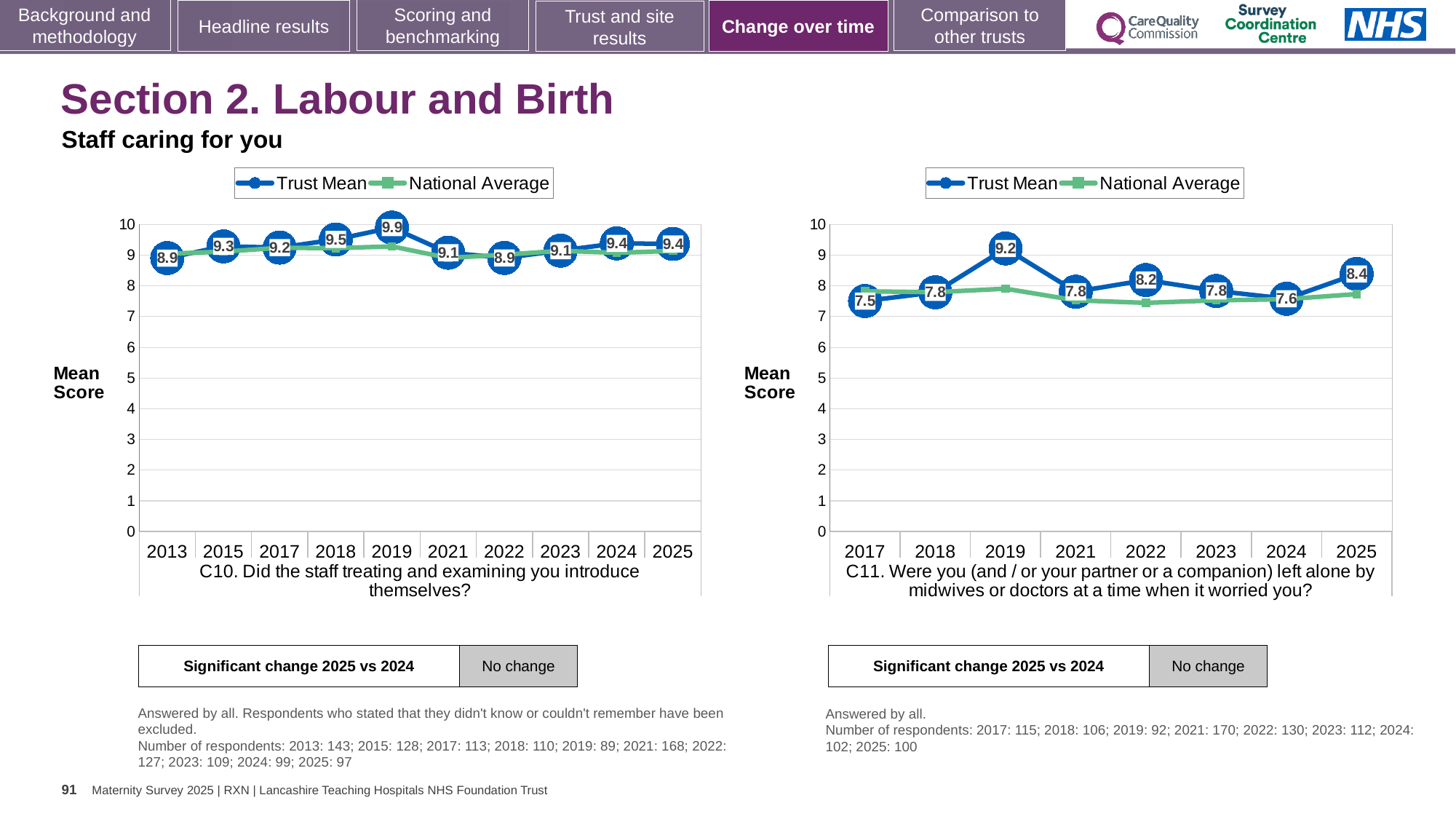
In the C11 chart on the right, which year has the highest Trust Mean? 2019 In the C11 chart on the right, which year has the lowest Trust Mean? 2017 In the C10 chart on the left, what is the Trust Mean for 2013? 8.9 In the C10 chart on the left, what is the Trust Mean for 2019? 9.9 In the C10 chart on the left, what is the difference between the Trust Mean for 2019 and 2022? 1.0 How many series does the legend of the C11 chart on the right list? 2 In the C10 chart on the left, how many years are shown on the x axis? 10 What type of chart is the C10 chart on the left? Line chart In the C11 chart on the right, is the National Average for 2022 greater or less than 8? less In the C11 chart on the right, is the Trust Mean for 2022 larger than the Trust Mean for 2024? Yes, 2022 (8.2) is larger In the C11 chart on the right, what is the Trust Mean for 2025? 8.4 In the C10 chart on the left, which year has the highest Trust Mean? 2019